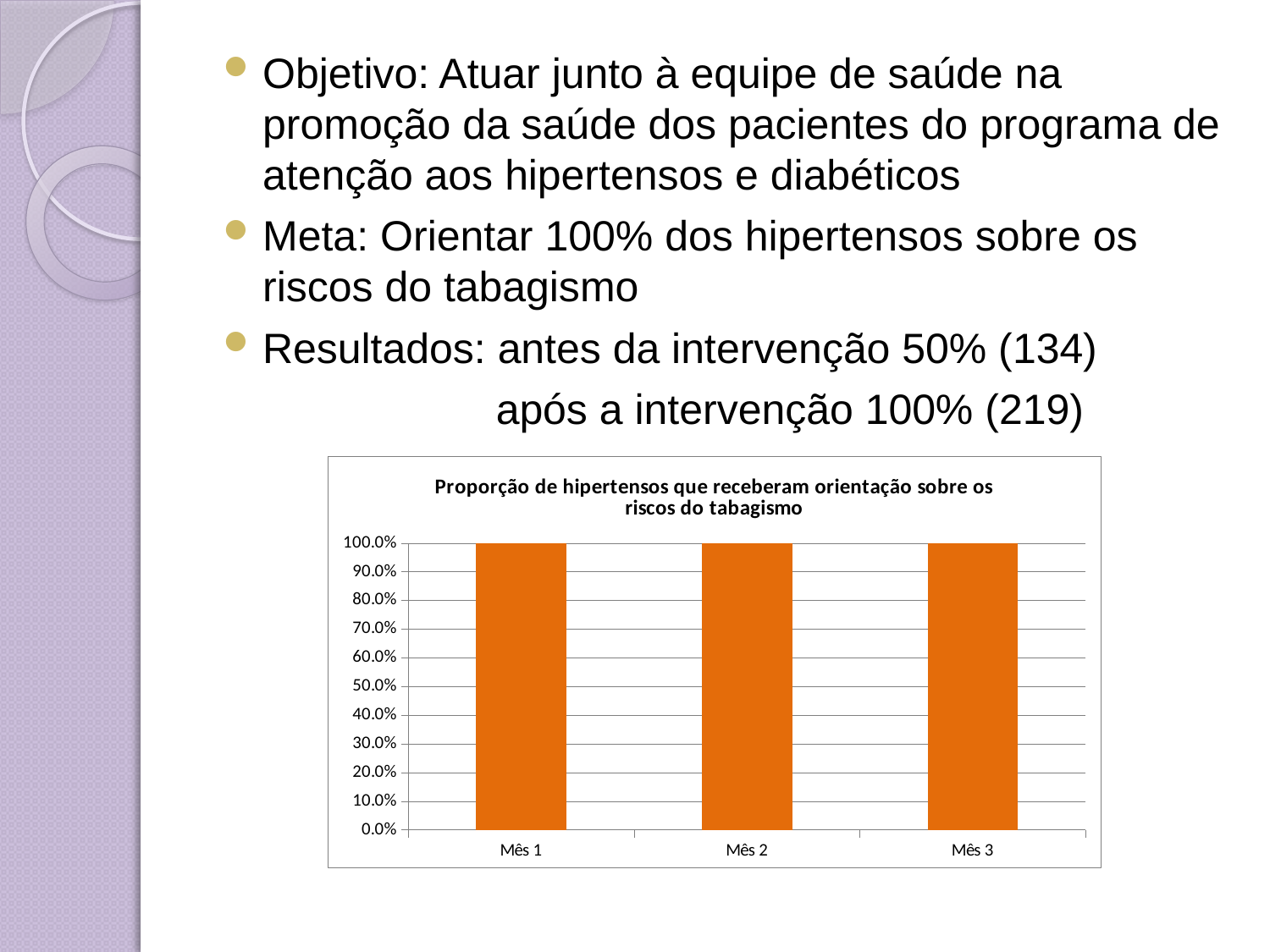
Do the values rise, fall, or stay flat from Mês 1 to Mês 3? stay flat What is the value for Mês 2? 100.0% What colour are the bars in the chart? orange What is the difference between the values for Mês 2 and Mês 1? 0.0% Is the value for Mês 3 greater or less than 90.0%? greater What kind of chart is shown on the slide? bar chart What is the highest value shown on the y axis of the chart? 100.0% What is the value for Mês 3? 100.0% What is the value for Mês 1? 100.0% What is the title of the chart? Proporção de hipertensos que receberam orientação sobre os riscos do tabagismo How many categories are shown on the x axis of the chart? 3 Is the value for Mês 1 greater or less than 50.0%? greater